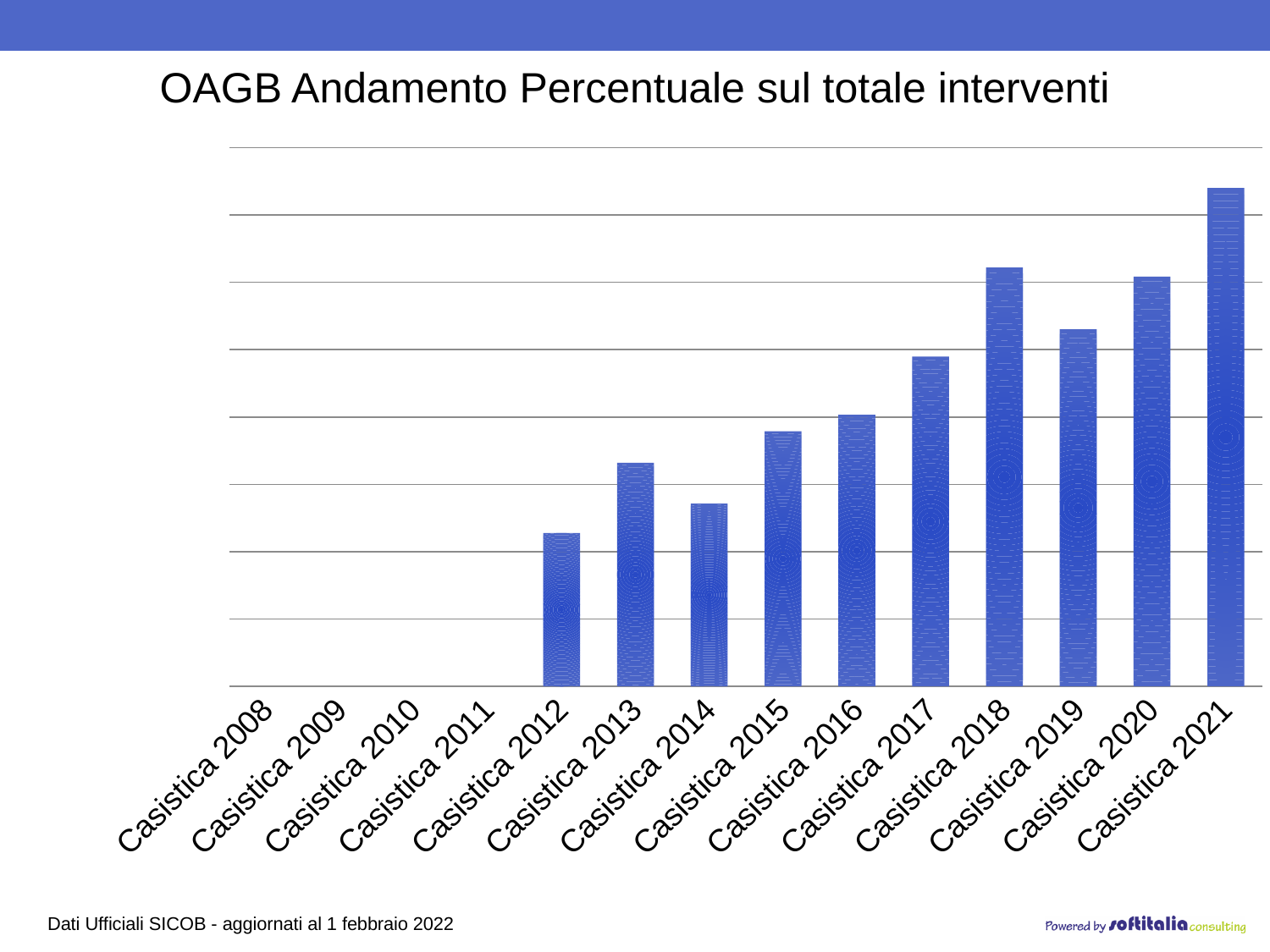
Which is the first category on the x axis that has a visible bar? Casistica 2012 What kind of chart is shown on the slide? bar chart Which is larger, the bar for Casistica 2015 or the bar for Casistica 2012? Casistica 2015 Which is larger, the bar for Casistica 2013 or the bar for Casistica 2014? Casistica 2013 How many categories are shown on the x axis of the chart? 14 What is the title of the chart? OAGB Andamento Percentuale sul totale interventi Which category has the highest bar in the chart? Casistica 2021 Among the categories with a visible bar, which has the lowest bar? Casistica 2012 Which is larger, the bar for Casistica 2020 or the bar for Casistica 2021? Casistica 2021 Do the bar values generally rise or fall from Casistica 2012 to Casistica 2021? rise